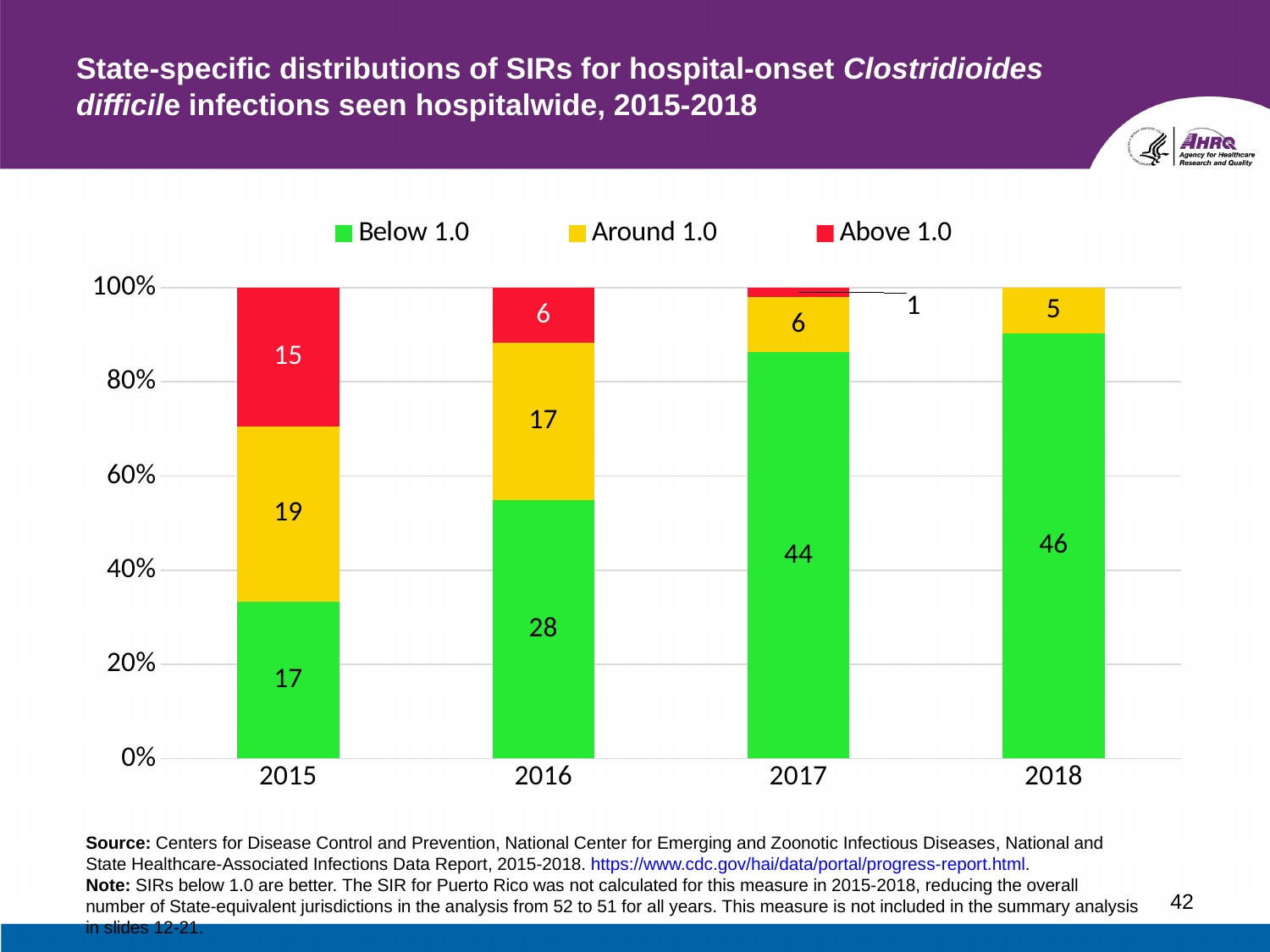
Which year has the lowest number of states with SIRs above 1.0 among the years with a labeled Above 1.0 segment? 2017 Which is larger: the number of states with SIRs around 1.0 in 2015 or in 2017? 2015 What kind of chart is shown on the slide? Stacked bar chart What is the number of states with SIRs above 1.0 in 2017? 1 How many years are shown on the x axis? 4 What is the number of states with SIRs around 1.0 in 2016? 17 Which year has the highest number of states with SIRs below 1.0? 2018 What is the total number of states represented in the 2016 bar (sum of all three segments)? 51 What is the difference between the number of states with SIRs below 1.0 in 2016 and in 2015? 11 What is the number of states with SIRs below 1.0 in 2015? 17 What is the number of states with SIRs below 1.0 in 2018? 46 How many series does the legend list? 3